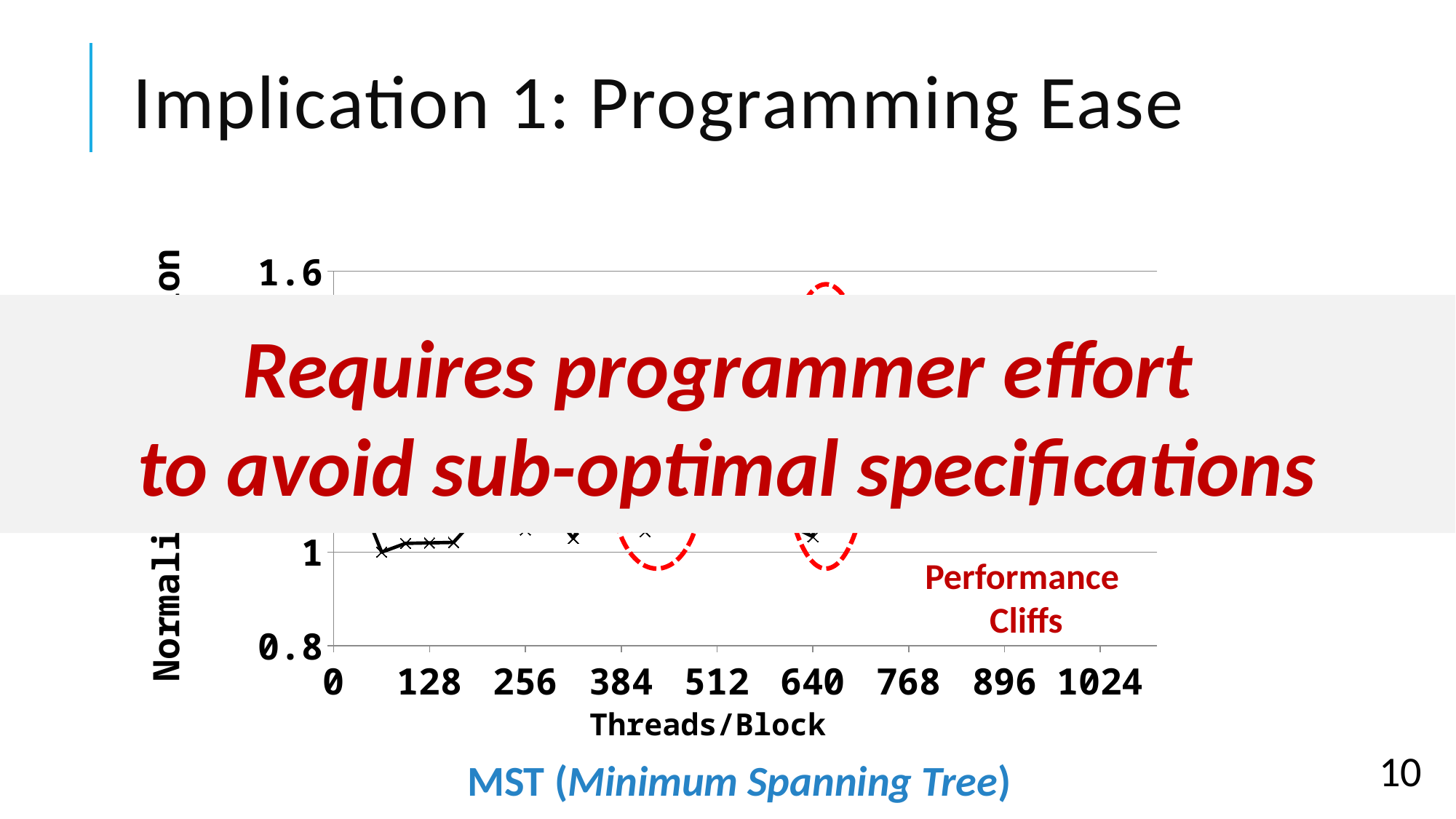
What is the highest tick value shown on the y axis of the chart? 1.6 What kind of chart is shown on the slide? line chart Is the plotted value at 320 Threads/Block greater or less than 0.8? greater Is the plotted value at 128 Threads/Block greater or less than 0.8? greater What is the label of the x axis of the chart? Threads/Block How many tick labels are shown on the x axis of the chart? 9